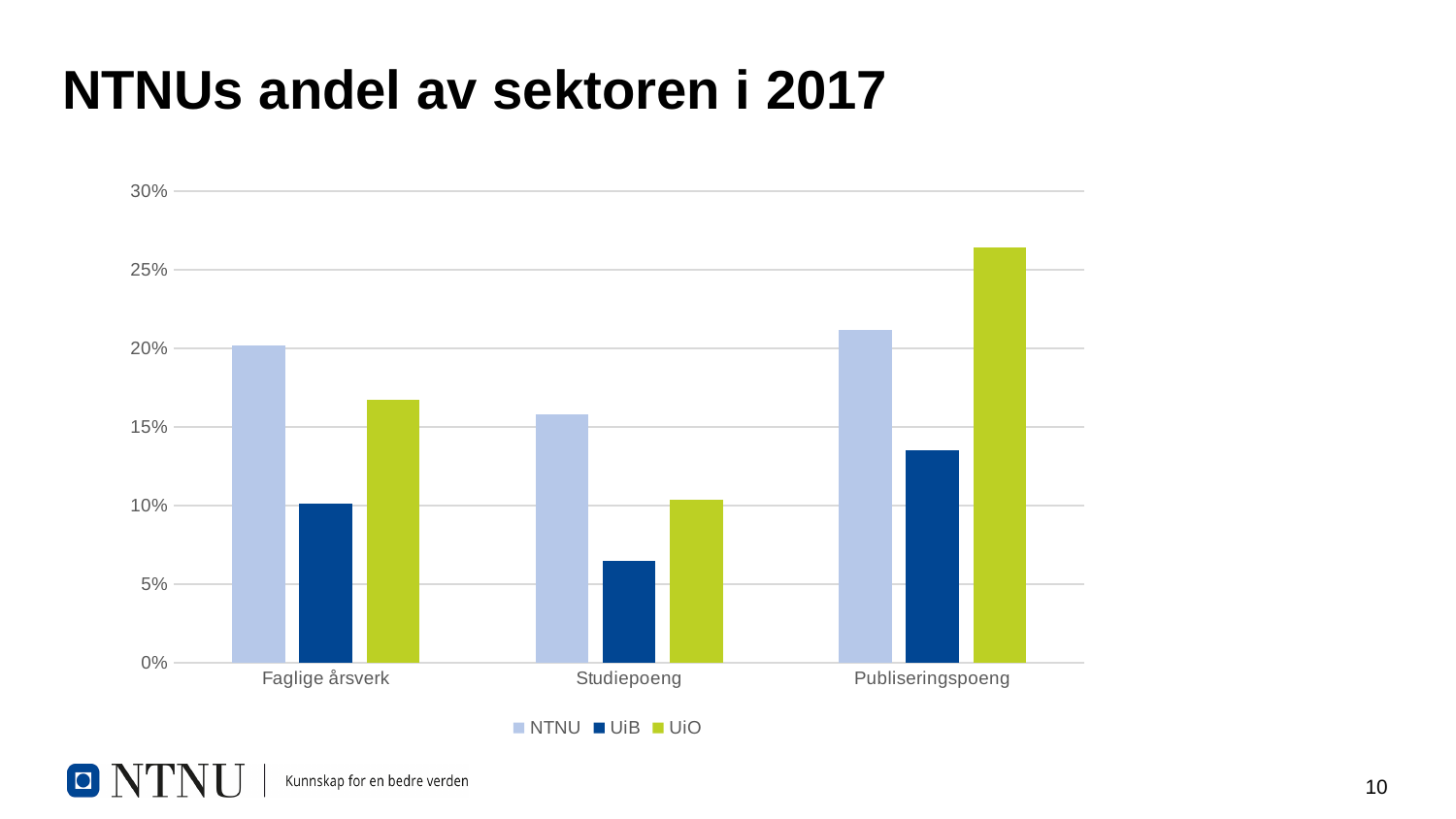
Is the value for UiB in Publiseringspoeng greater or less than 15%? less Is the value for UiB in Studiepoeng greater or less than 10%? less What is the title of the chart on the slide? NTNUs andel av sektoren i 2017 How many series does the legend list? 3 What kind of chart is shown on the slide? bar chart How many categories are shown on the x axis? 3 Which series has the lowest value for Studiepoeng? UiB Which is larger: NTNU's value for Studiepoeng or UiO's value for Studiepoeng? NTNU's value for Studiepoeng Is the value for UiO in Publiseringspoeng greater or less than 25%? greater Which series has the highest value for Publiseringspoeng? UiO Which series has the highest value for Faglige årsverk? NTNU